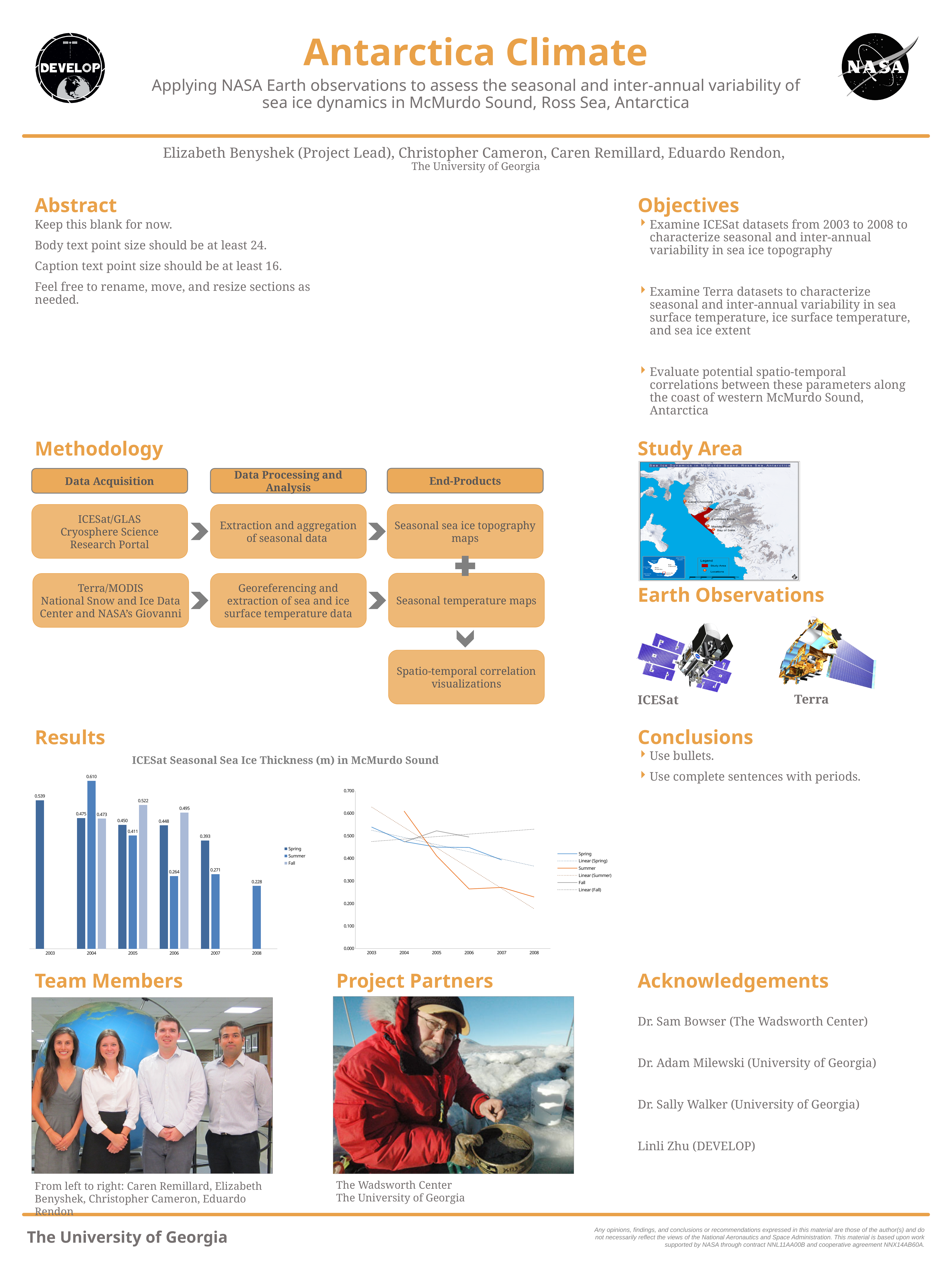
In the bar chart titled 'ICESat Seasonal Sea Ice Thickness (m) in McMurdo Sound', what is the Fall value for 2005? 0.522 In the bar chart titled 'ICESat Seasonal Sea Ice Thickness (m) in McMurdo Sound', how many years are shown on the x axis? 6 In the line chart on the right of the Results section, does the Summer line rise or fall from 2004 to 2008? Fall In the bar chart titled 'ICESat Seasonal Sea Ice Thickness (m) in McMurdo Sound', which is larger for 2006: the Spring value or the Fall value? Fall What kind of chart is the chart titled 'ICESat Seasonal Sea Ice Thickness (m) in McMurdo Sound'? Bar chart In the line chart on the right of the Results section, how many entries does the legend list? 6 In the bar chart titled 'ICESat Seasonal Sea Ice Thickness (m) in McMurdo Sound', which year has the highest Summer value? 2004 In the bar chart titled 'ICESat Seasonal Sea Ice Thickness (m) in McMurdo Sound', what is the Summer value for 2004? 0.610 In the bar chart titled 'ICESat Seasonal Sea Ice Thickness (m) in McMurdo Sound', how many series does the legend list? 3 In the bar chart titled 'ICESat Seasonal Sea Ice Thickness (m) in McMurdo Sound', what is the difference between the Summer values for 2004 and 2008? 0.382 In the bar chart titled 'ICESat Seasonal Sea Ice Thickness (m) in McMurdo Sound', which year has the lowest Summer value? 2008 In the bar chart titled 'ICESat Seasonal Sea Ice Thickness (m) in McMurdo Sound', what is the Spring value for 2003? 0.539